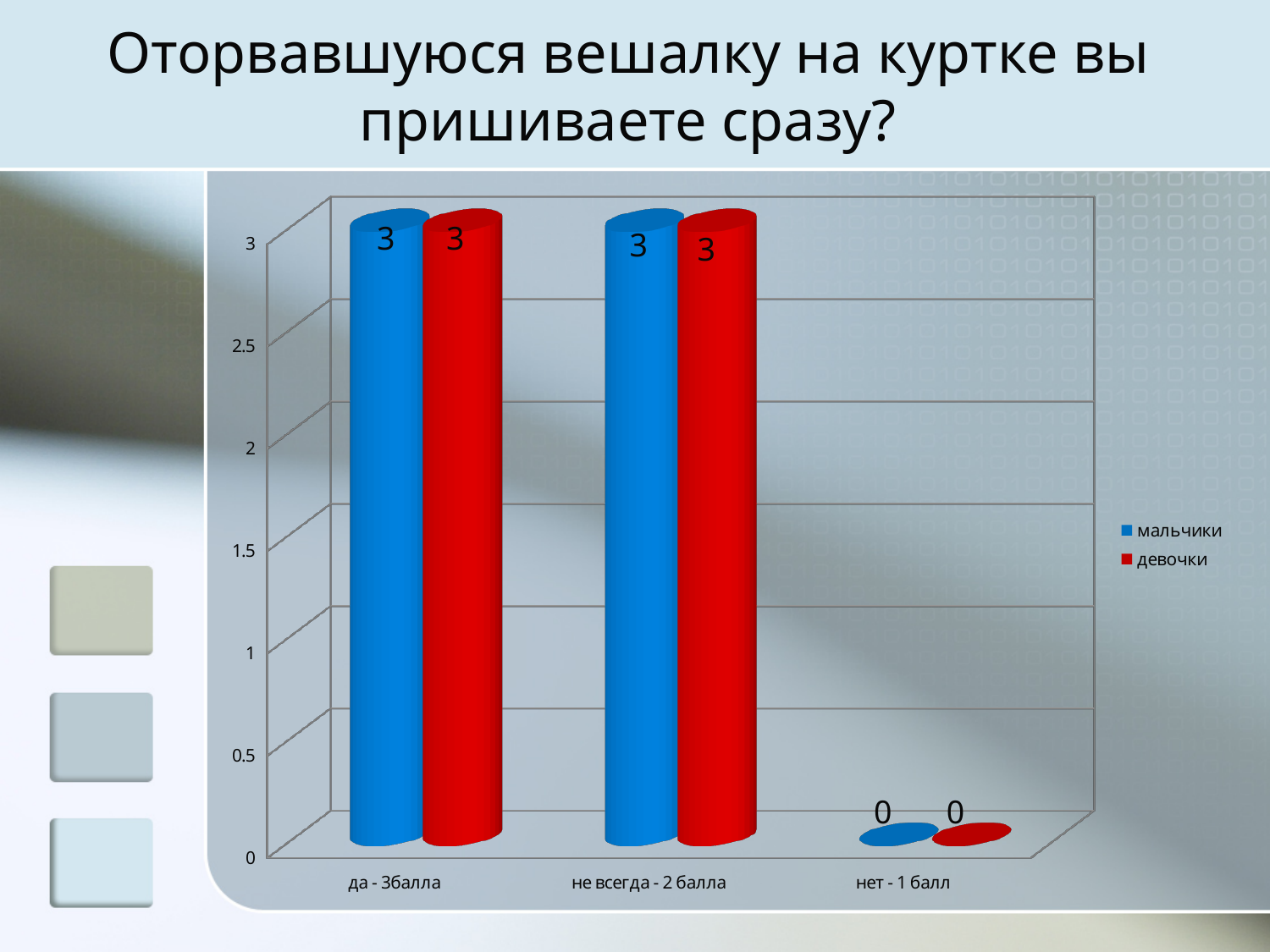
Which series is shown in red? девочки What is the title of the slide? Оторвавшуюся вешалку на куртке вы пришиваете сразу? What is the value for девочки in the category 'нет - 1 балл'? 0 How many categories are shown on the x axis? 3 What is the value for мальчики in the category 'да - 3балла'? 3 What kind of chart is shown on the slide? Bar chart What is the difference between the мальчики value for 'да - 3балла' and the мальчики value for 'нет - 1 балл'? 3 What is the value for девочки in the category 'не всегда - 2 балла'? 3 Is the value for девочки in 'да - 3балла' larger than the value for девочки in 'нет - 1 балл'? Yes Which category has the lowest value for девочки? нет - 1 балл How many series does the legend list? 2 What is the value for мальчики in the category 'нет - 1 балл'? 0